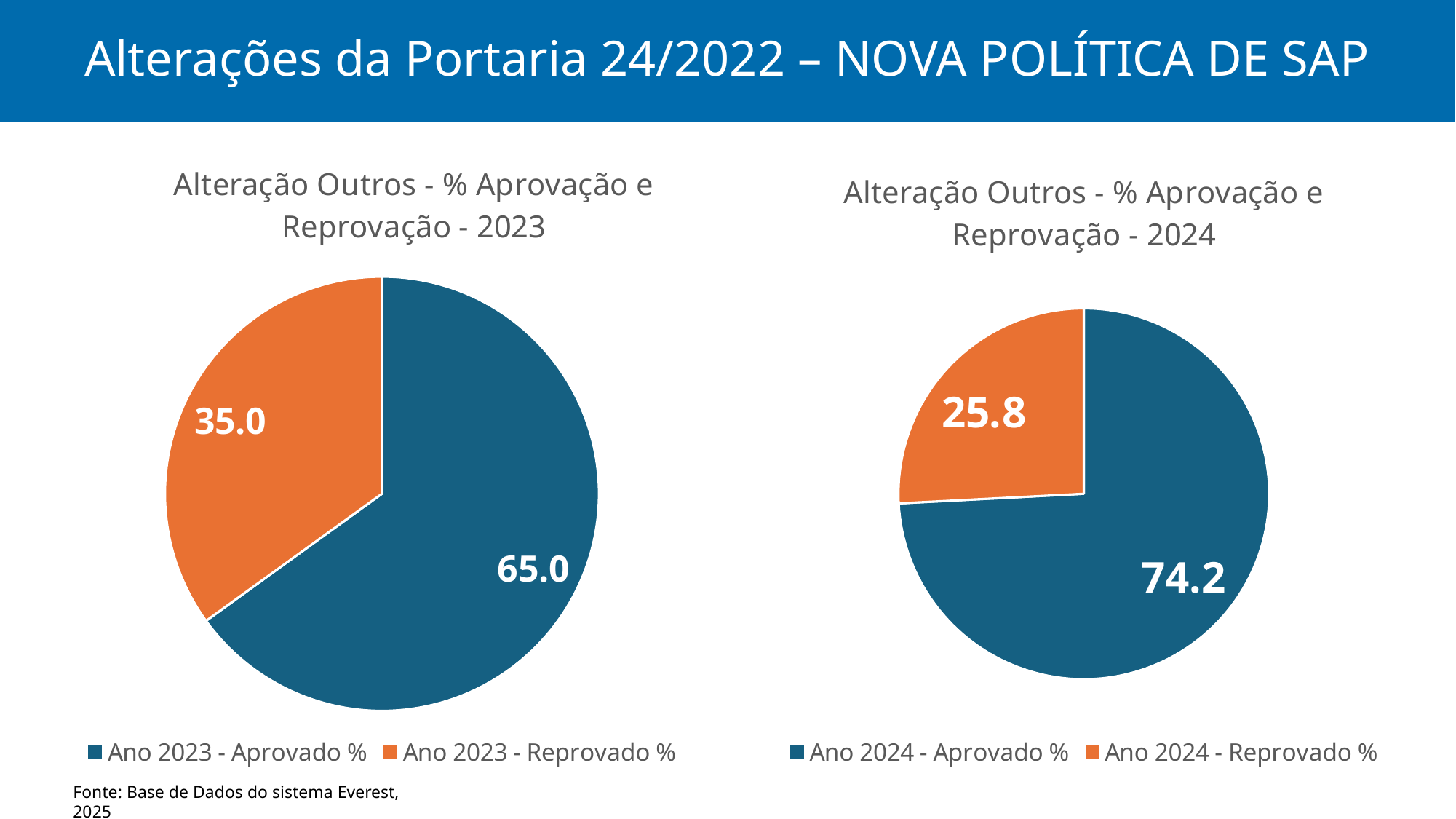
In the 2024 chart (right), what is the value for Ano 2024 - Reprovado %? 25.8 Which is larger: the Aprovado value in the 2023 chart or the Aprovado value in the 2024 chart? 2024 chart (74.2) What kind of chart is the 2024 chart (right)? Pie chart In the 2023 chart (left), what is the difference between the Aprovado and Reprovado values? 30.0 What is the title of the chart on the right? Alteração Outros - % Aprovação e Reprovação - 2024 In the 2023 chart (left), what is the value for Ano 2023 - Reprovado %? 35.0 In the 2024 chart (right), what is the value for Ano 2024 - Aprovado %? 74.2 In the 2023 chart (left), which slice is the largest? Ano 2023 - Aprovado % In the 2024 chart (right), which slice is the smallest? Ano 2024 - Reprovado % How many slices does the 2023 chart (left) have? 2 In the 2023 chart (left), what is the value for Ano 2023 - Aprovado %? 65.0 In the 2024 chart (right), what is the difference between the Aprovado and Reprovado values? 48.4